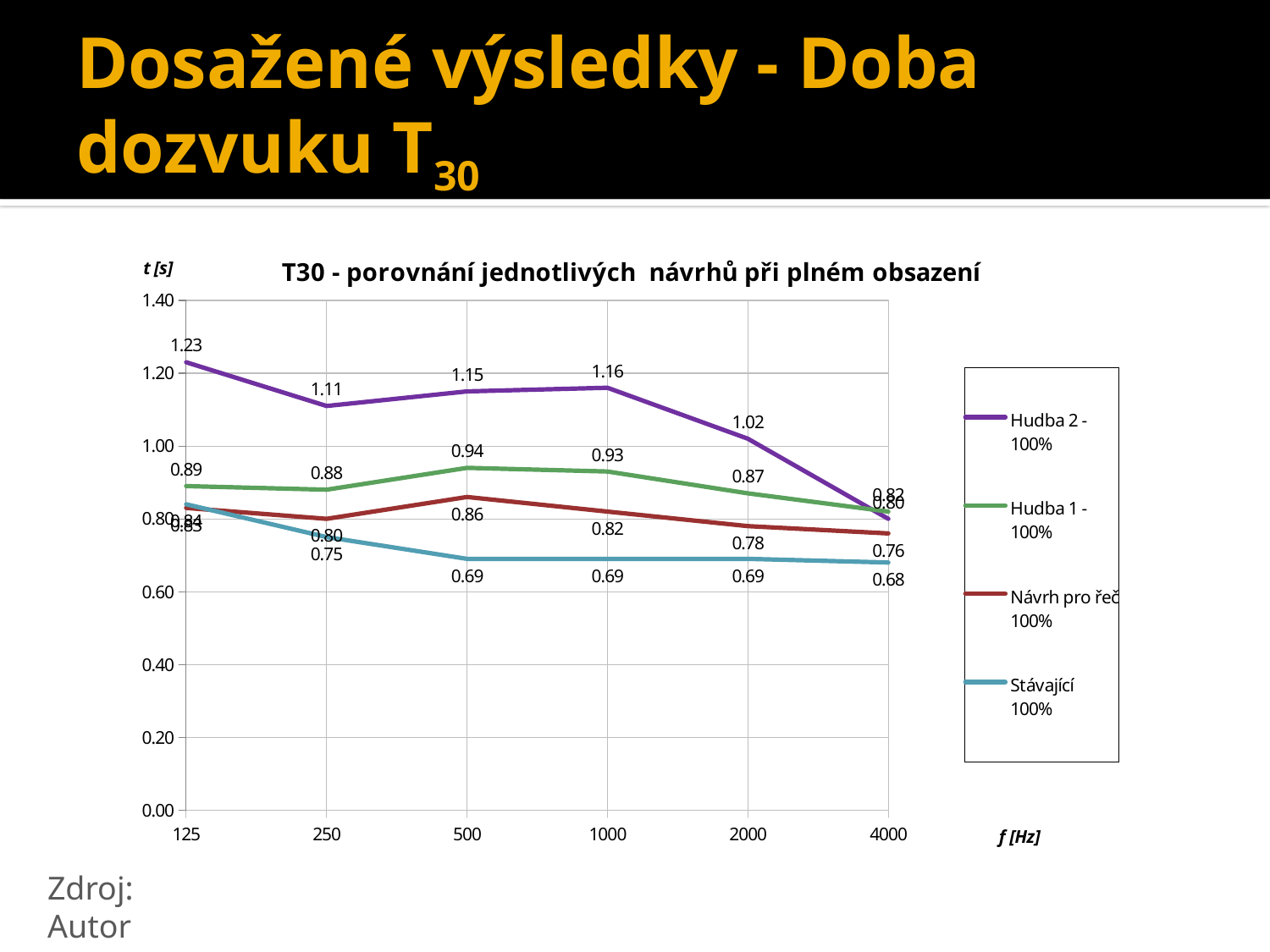
At 500 Hz, which is larger: Hudba 1 - 100% or Návrh pro řeč 100%? Hudba 1 - 100% What is the difference between the Hudba 2 - 100% and Hudba 1 - 100% values at 1000 Hz? 0.23 How many frequency points are plotted along the x axis? 6 Does the Stávající 100% series rise or fall as frequency increases from 125 Hz to 4000 Hz? fall At which frequency does the Hudba 2 - 100% series reach its highest value? 125 What is the value of the Hudba 2 - 100% series at 125 Hz? 1.23 What is the title of the chart? T30 - porovnání jednotlivých návrhů při plném obsazení What kind of chart is shown on the slide? line chart What is the value of the Návrh pro řeč 100% series at 2000 Hz? 0.78 What is the value of the Stávající 100% series at 4000 Hz? 0.68 Is the value of Hudba 2 - 100% at 2000 Hz greater or less than 1.00? greater How many series does the legend list? 4